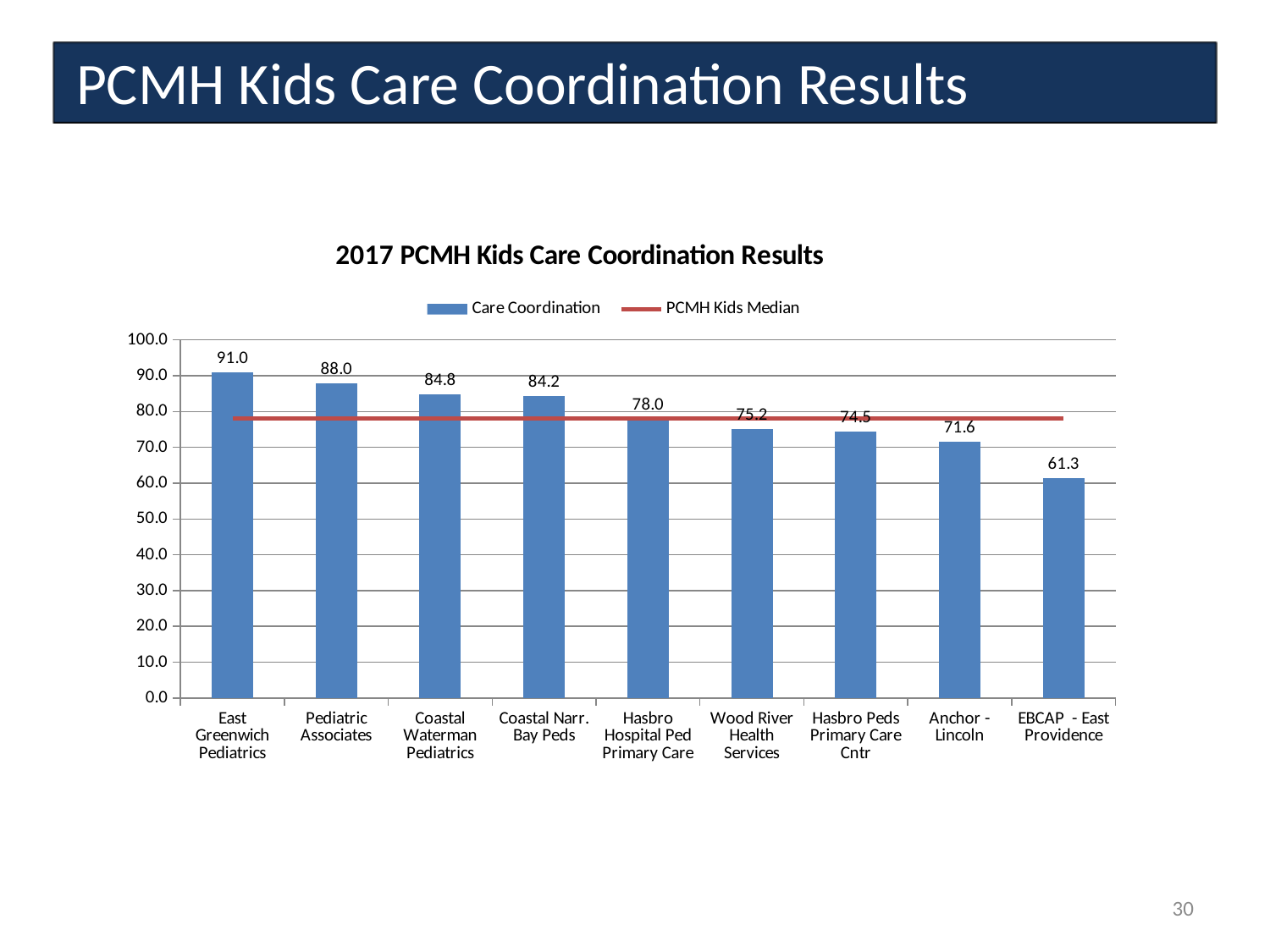
What is the Care Coordination value for Anchor - Lincoln? 71.6 Which practice has the highest Care Coordination value? East Greenwich Pediatrics What is the Care Coordination value for Wood River Health Services? 75.2 How many practices are shown on the x axis? 9 What kind of chart is shown on the slide? Combination bar and line chart Which practice has the lowest Care Coordination value? EBCAP - East Providence How many series does the legend list? 2 What is the title of the chart? 2017 PCMH Kids Care Coordination Results Is the PCMH Kids Median line greater or less than 80.0? less What is the Care Coordination value for East Greenwich Pediatrics? 91.0 What is the difference between the Care Coordination values for Pediatric Associates and Coastal Waterman Pediatrics? 3.2 Which has a higher Care Coordination value, Hasbro Hospital Ped Primary Care or Hasbro Peds Primary Care Cntr? Hasbro Hospital Ped Primary Care